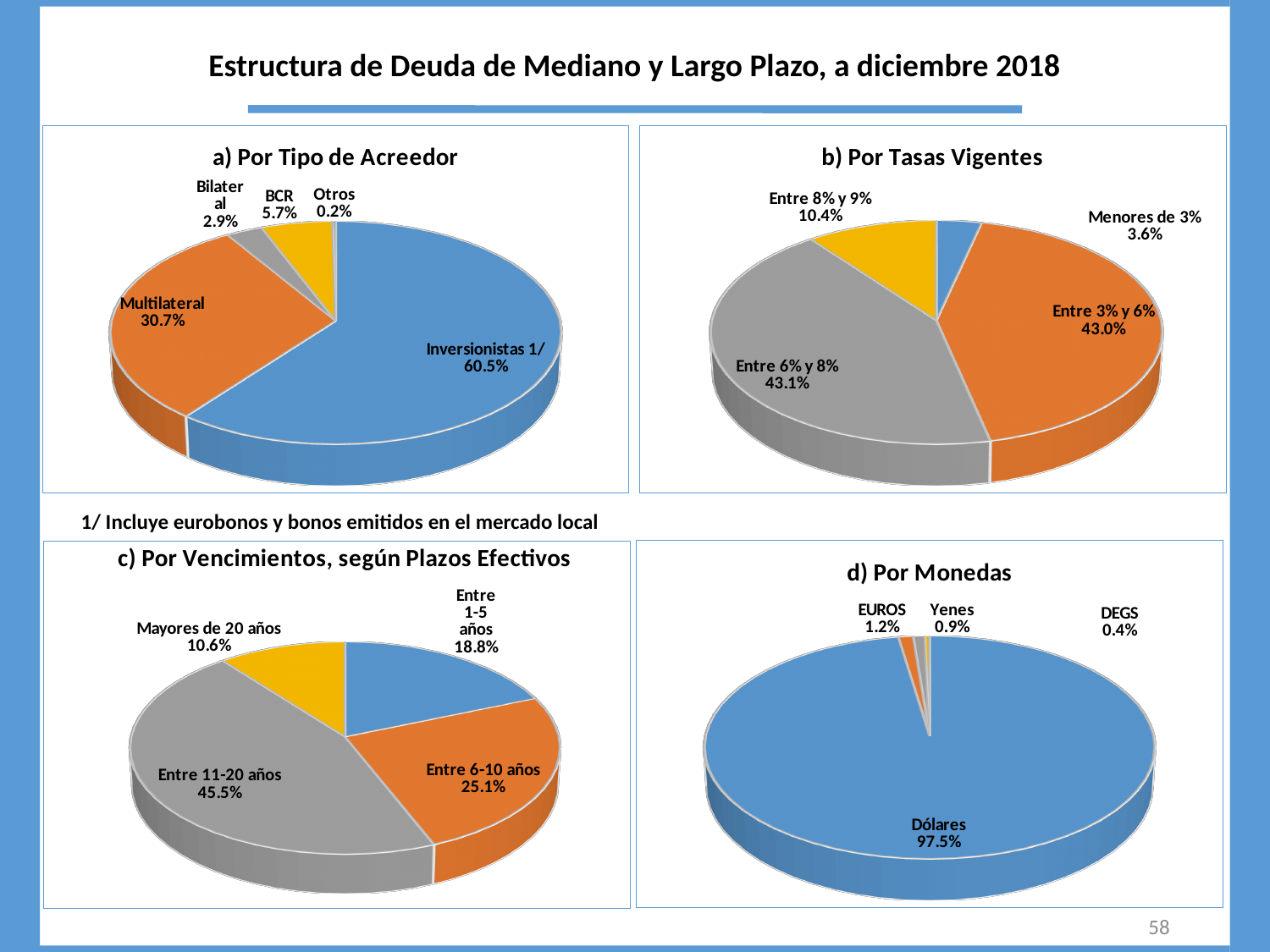
In chart b) Por Tasas Vigentes, what share corresponds to Entre 8% y 9%? 10.4% In chart c) Por Vencimientos, según Plazos Efectivos, which is larger: the share for Entre 1-5 años or for Mayores de 20 años? Entre 1-5 años In chart b) Por Tasas Vigentes, how many rate bands are shown? 4 In chart d) Por Monedas, what share of the debt is in Dólares? 97.5% What type of chart is used in chart d) Por Monedas? Pie chart In chart a) Por Tipo de Acreedor, what is the difference between the Multilateral share and the BCR share? 25.0% In chart d) Por Monedas, what is the difference between the EUROS share and the Yenes share? 0.3% In chart c) Por Vencimientos, según Plazos Efectivos, which maturity band has the largest share? Entre 11-20 años In chart c) Por Vencimientos, según Plazos Efectivos, what share corresponds to Entre 6-10 años? 25.1% In chart b) Por Tasas Vigentes, which rate band has the smallest share? Menores de 3% In chart a) Por Tipo de Acreedor, which creditor type has the smallest share? Otros In chart a) Por Tipo de Acreedor, what share of the debt corresponds to Inversionistas 1/? 60.5%